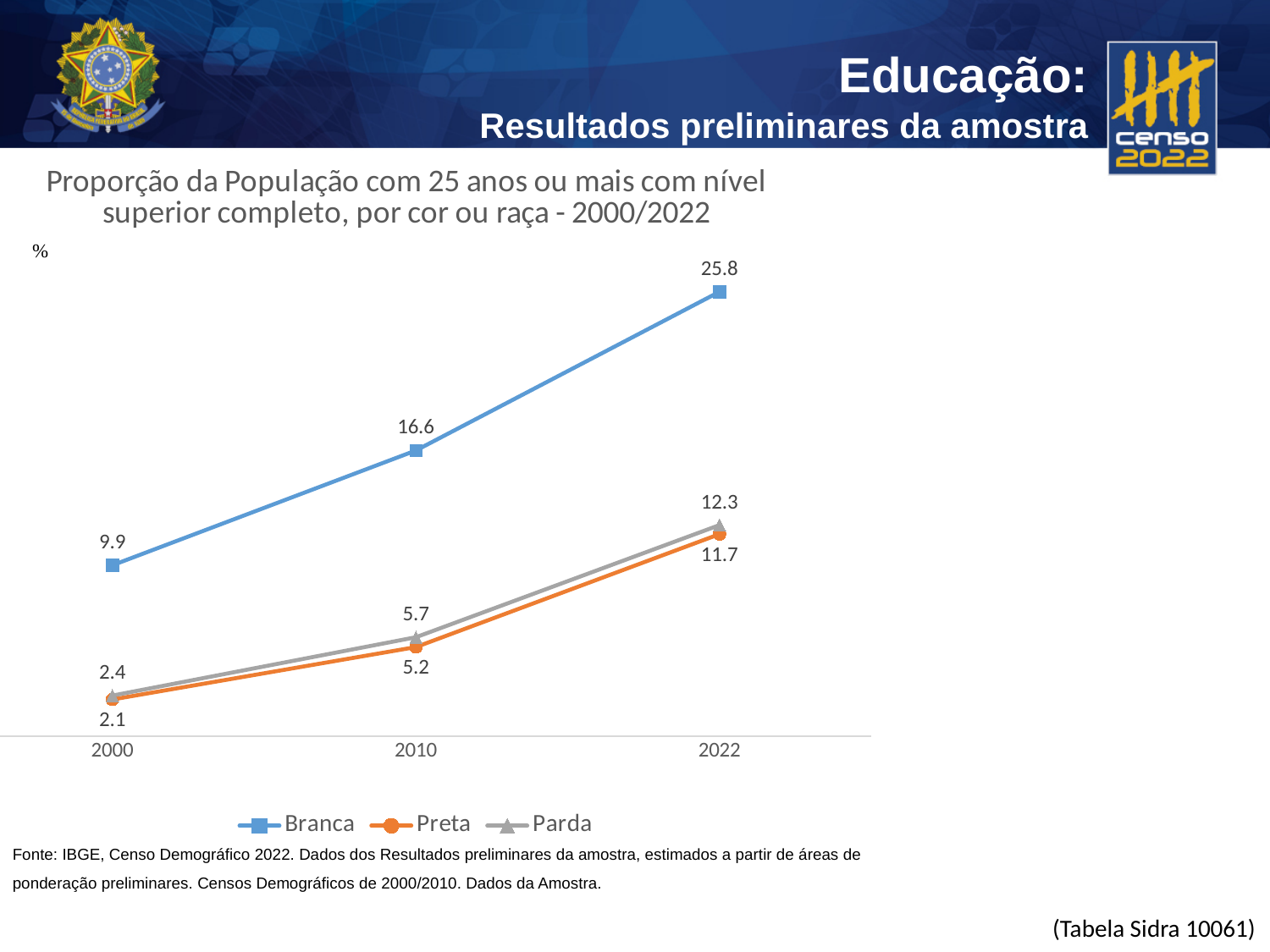
Which series has the lowest value in 2000? Preta What is the difference between Parda and Preta in 2022? 0.6 Which is larger, the Branca value in 2010 or the Parda value in 2022? Branca value in 2010 Which series has the highest value in 2022? Branca How many series does the legend list? 3 What is the value for Branca in 2022? 25.8 What is the value for Parda in 2010? 5.7 How many years are shown on the x axis? 3 What is the difference between the Branca values in 2022 and 2000? 15.9 What is the value for Preta in 2022? 11.7 What is the value for Branca in 2000? 9.9 What kind of chart is shown on the slide? Line chart